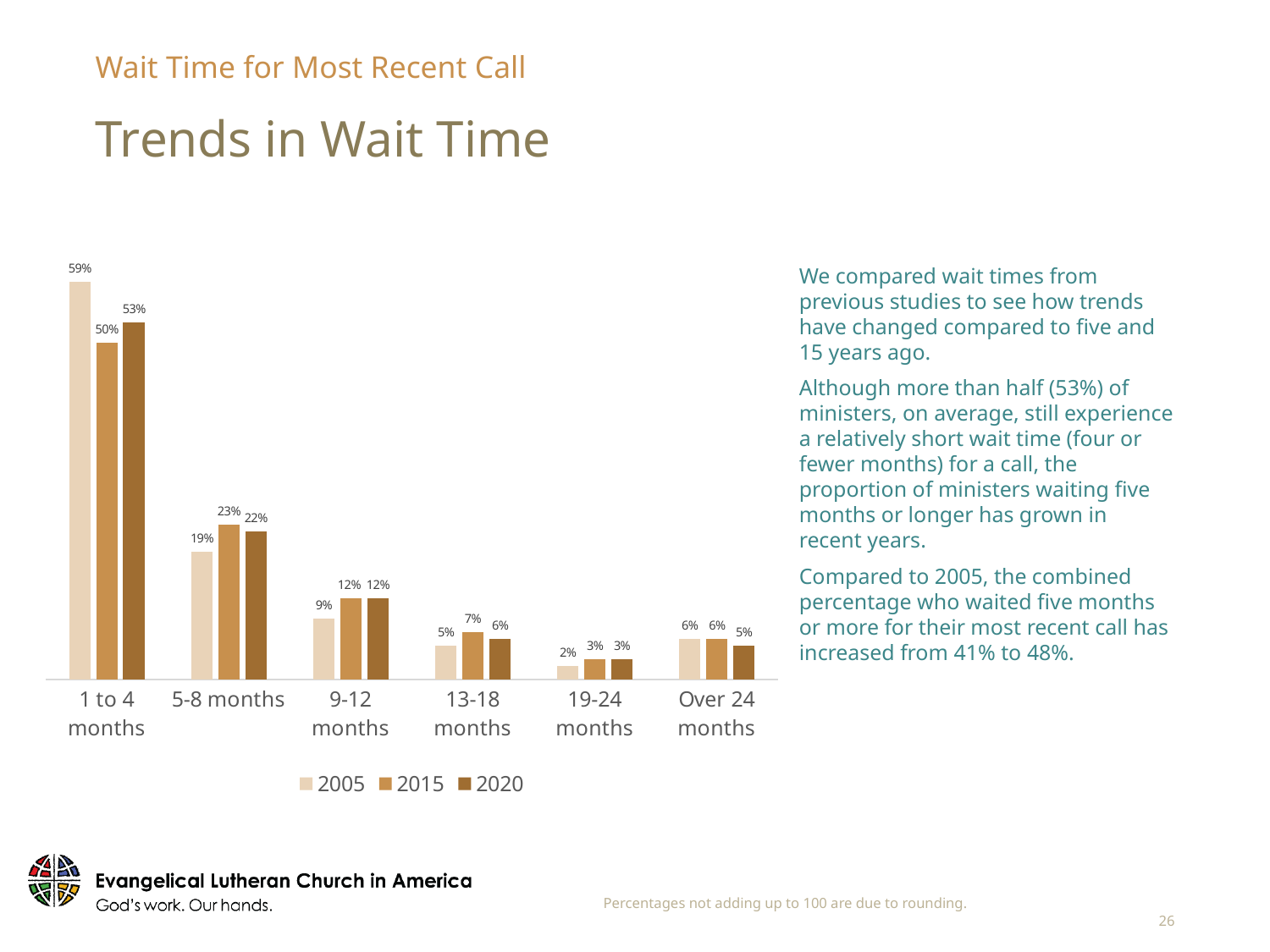
What kind of chart is shown on the slide? Bar chart How many series does the legend list? 3 What is the value for 2015 in the 13-18 months category? 7% Which years are listed in the chart legend? 2005, 2015, 2020 What is the difference between the 2005 and 2015 values in the 1 to 4 months category? 9% How many categories are shown on the x axis? 6 What is the value for 2020 in the 5-8 months category? 22% Which category has the highest value for the 2020 series? 1 to 4 months Which category has the lowest value for the 2005 series? 19-24 months What is the value for 2005 in the 1 to 4 months category? 59% Which is larger in the 5-8 months category: the 2005 value or the 2015 value? 2015 Do the 2020 values rise or fall from the 1 to 4 months category to the 19-24 months category? Fall